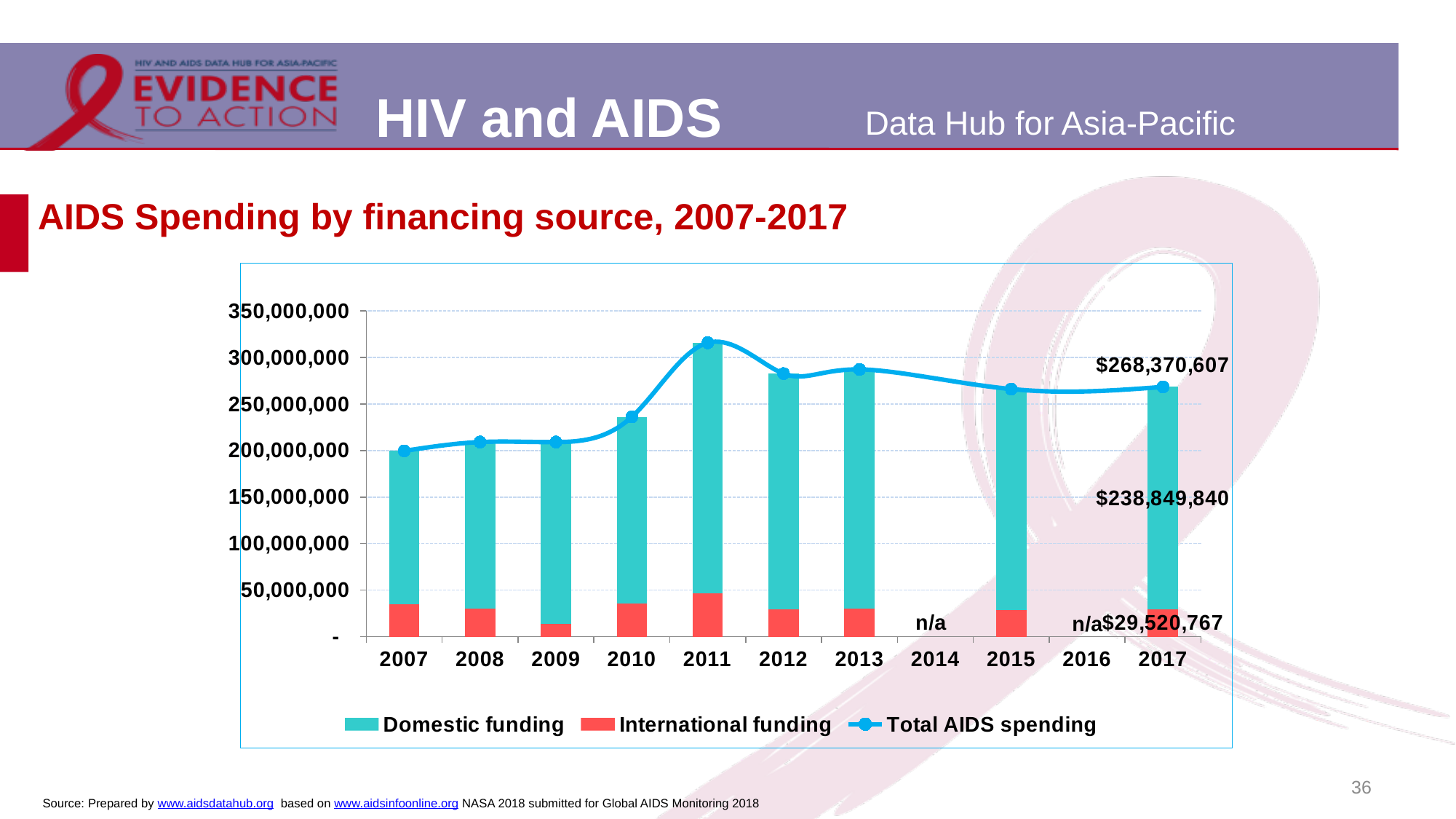
What is the difference between Domestic funding and International funding in 2017? $209,329,073 Is the Total AIDS spending for 2011 greater or less than 300,000,000? greater How many series does the legend list? 3 Among the years with data, which year has the lowest International funding? 2009 Which year has higher Total AIDS spending, 2011 or 2013? 2011 Which years are marked n/a on the chart? 2014 and 2016 Is the Total AIDS spending for 2007 greater or less than 250,000,000? less What is the Domestic funding value labelled for 2017? $238,849,840 What is the Total AIDS spending value labelled for 2017? $268,370,607 How many years are shown on the x axis? 11 What is the International funding value labelled for 2017? $29,520,767 In which year is Total AIDS spending highest? 2011